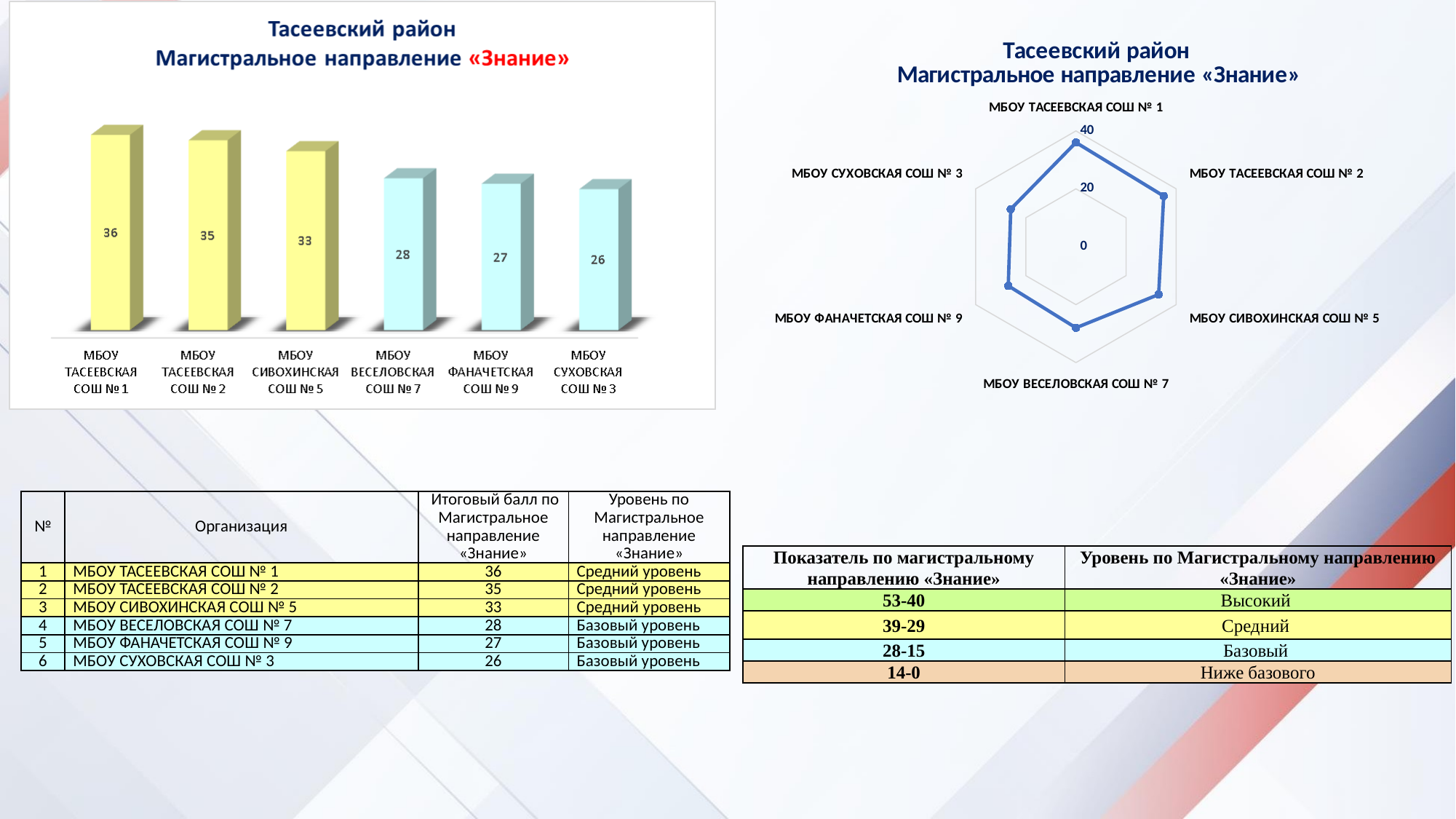
On the bar chart on the left, what is the value for МБОУ ФАНАЧЕТСКАЯ СОШ № 9? 27 What kind of chart is the chart on the left of the slide? Bar chart On the bar chart on the left, which school has the highest value? МБОУ ТАСЕЕВСКАЯ СОШ № 1 On the bar chart on the left, what is the value for МБОУ ТАСЕЕВСКАЯ СОШ № 1? 36 On the bar chart on the left, do the values rise or fall from left to right? Fall How many schools are plotted on the radar chart on the right? 6 What kind of chart is the chart on the right of the slide? Radar chart On the bar chart on the left, which school has the lowest value? МБОУ СУХОВСКАЯ СОШ № 3 On the bar chart on the left, which is larger: the value for МБОУ СИВОХИНСКАЯ СОШ № 5 or МБОУ ВЕСЕЛОВСКАЯ СОШ № 7? МБОУ СИВОХИНСКАЯ СОШ № 5 On the radar chart on the right, is the value for МБОУ ТАСЕЕВСКАЯ СОШ № 1 greater or less than 20? greater How many bars are shown on the bar chart on the left? 6 On the bar chart on the left, what is the difference between the values for МБОУ ТАСЕЕВСКАЯ СОШ № 1 and МБОУ СУХОВСКАЯ СОШ № 3? 10